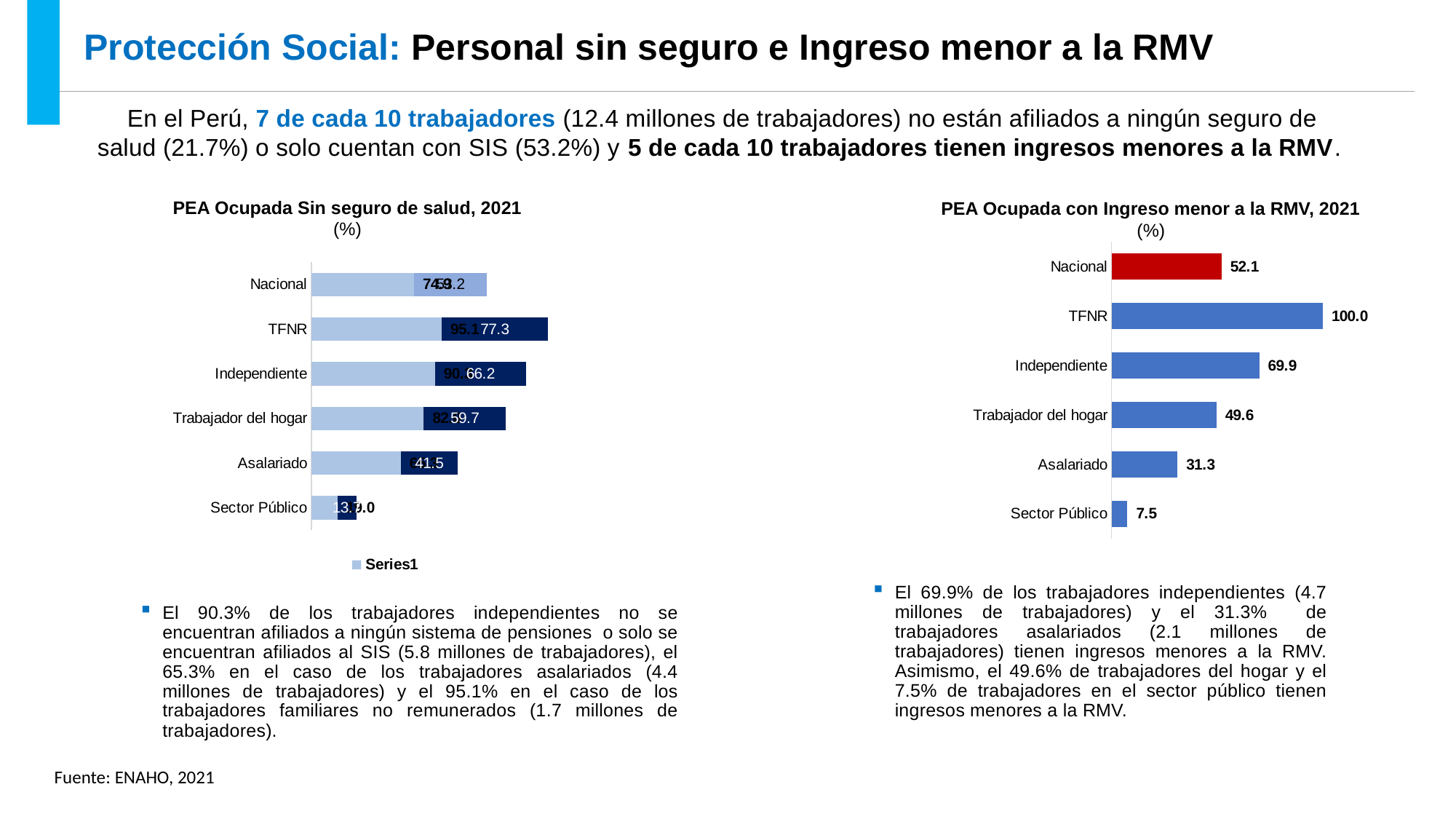
In the chart 'PEA Ocupada con Ingreso menor a la RMV, 2021', what is the value for Nacional? 52.1 In the chart 'PEA Ocupada con Ingreso menor a la RMV, 2021', which category has the lowest value? Sector Público What legend entry is shown below the chart 'PEA Ocupada Sin seguro de salud, 2021'? Series1 How many categories are shown in the chart 'PEA Ocupada con Ingreso menor a la RMV, 2021'? 6 In the chart 'PEA Ocupada con Ingreso menor a la RMV, 2021', which category has the highest value? TFNR In the chart 'PEA Ocupada con Ingreso menor a la RMV, 2021', what is the value for Sector Público? 7.5 In the chart 'PEA Ocupada con Ingreso menor a la RMV, 2021', which bar is coloured red? Nacional What kind of chart is 'PEA Ocupada con Ingreso menor a la RMV, 2021'? Bar chart In the chart 'PEA Ocupada con Ingreso menor a la RMV, 2021', what is the difference between the values for Independiente and Asalariado? 38.6 In the chart 'PEA Ocupada con Ingreso menor a la RMV, 2021', what is the value for Independiente? 69.9 In the chart 'PEA Ocupada con Ingreso menor a la RMV, 2021', which is larger, the value for Trabajador del hogar or the value for Asalariado? Trabajador del hogar